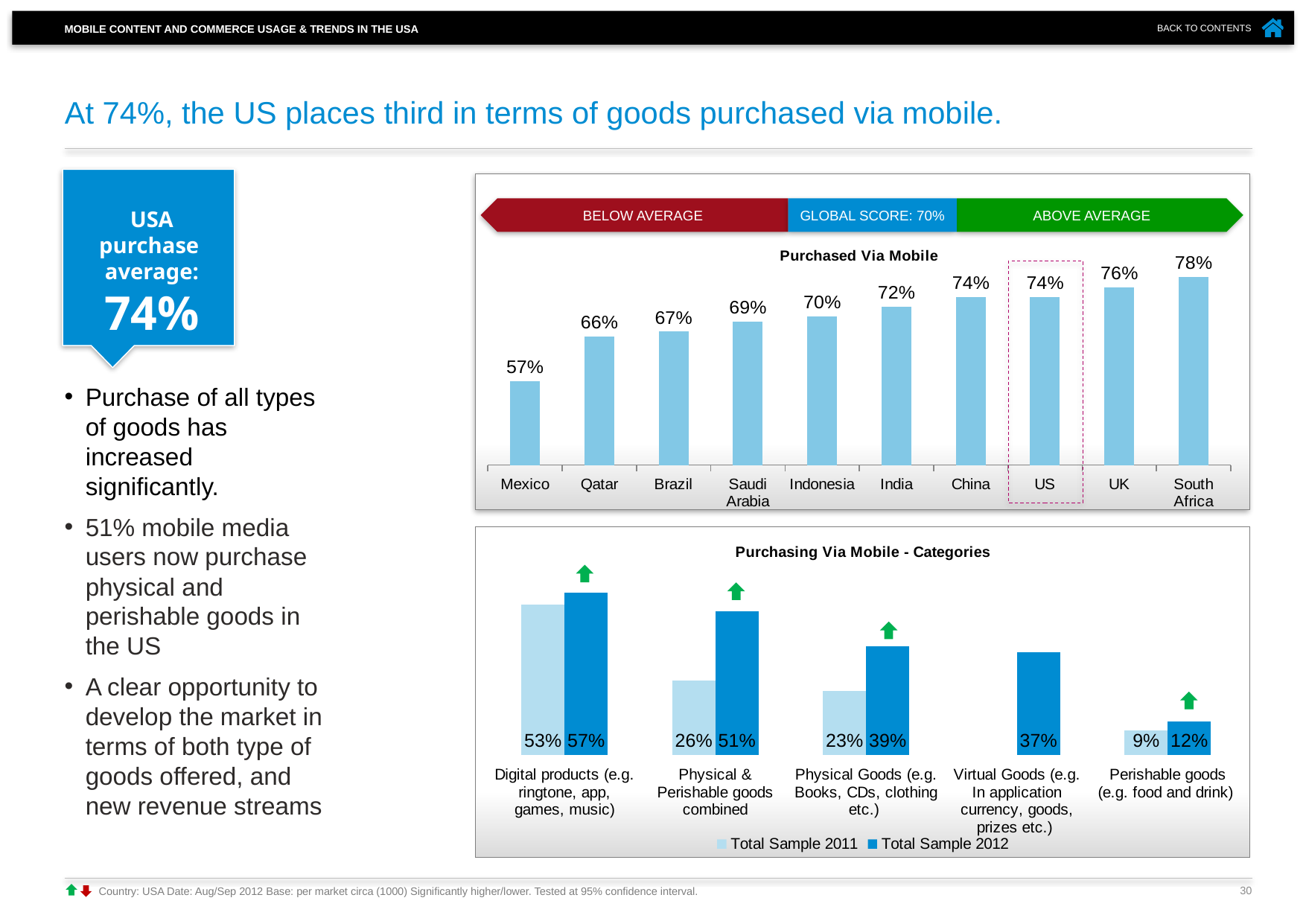
In the 'Purchasing Via Mobile - Categories' chart, what is the difference between the 2012 and 2011 values for Physical Goods (e.g. Books, CDs, clothing etc.)? 16% In the 'Purchased Via Mobile' chart, what is the value for Mexico? 57% In the 'Purchased Via Mobile' chart, what global score is shown in the banner above the bars? 70% In the 'Purchased Via Mobile' chart, which country has the highest value? South Africa In the 'Purchased Via Mobile' chart, which country has the lowest value? Mexico In the 'Purchasing Via Mobile - Categories' chart, how many series does the legend list? 2 In the 'Purchased Via Mobile' chart, how many countries are shown? 10 In the 'Purchasing Via Mobile - Categories' chart, what is the Total Sample 2011 value for Perishable goods (e.g. food and drink)? 9% What kind of chart is the 'Purchasing Via Mobile - Categories' chart? bar chart In the 'Purchasing Via Mobile - Categories' chart, what is the Total Sample 2012 value for Physical & Perishable goods combined? 51% In the 'Purchased Via Mobile' chart, do the values rise or fall from Mexico to South Africa? rise In the 'Purchased Via Mobile' chart, what is the difference between the UK and Brazil values? 9%